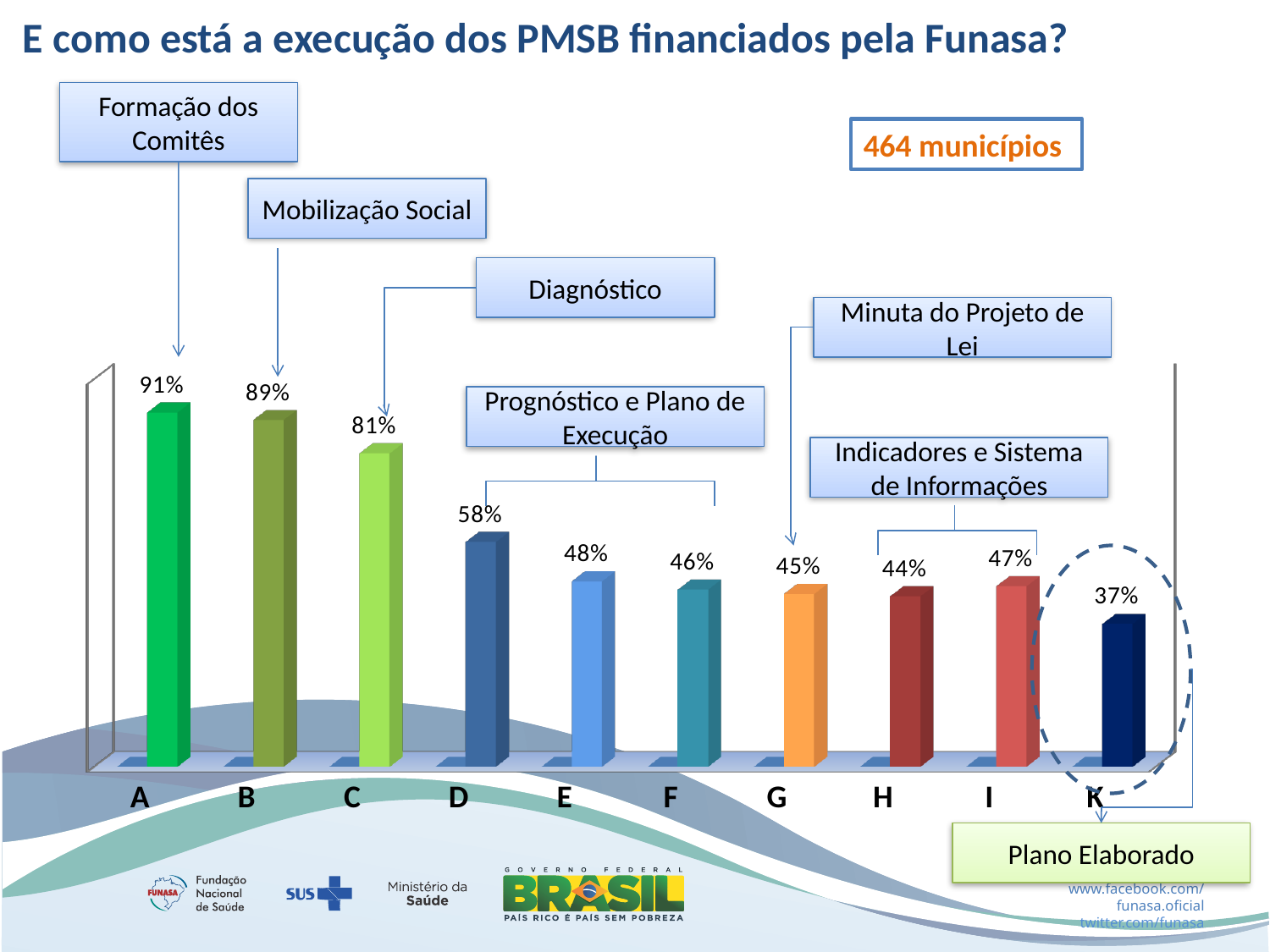
Which is larger, the value for H or the value for I? I What is the value shown for the last bar, labelled K (circled with a dashed line)? 37% Do the values generally rise or fall from category A to category K? Fall Which category has the lowest value? K Which category has the highest value? A Which label box points to the bar for category A? Formação dos Comitês What is the difference between the values for C and D? 23% What kind of chart is shown on the slide? Bar chart How many bars are plotted in the chart? 10 What is the difference between the values for A and B? 2% What is the value shown for category D? 58% What is the value shown for category A? 91%